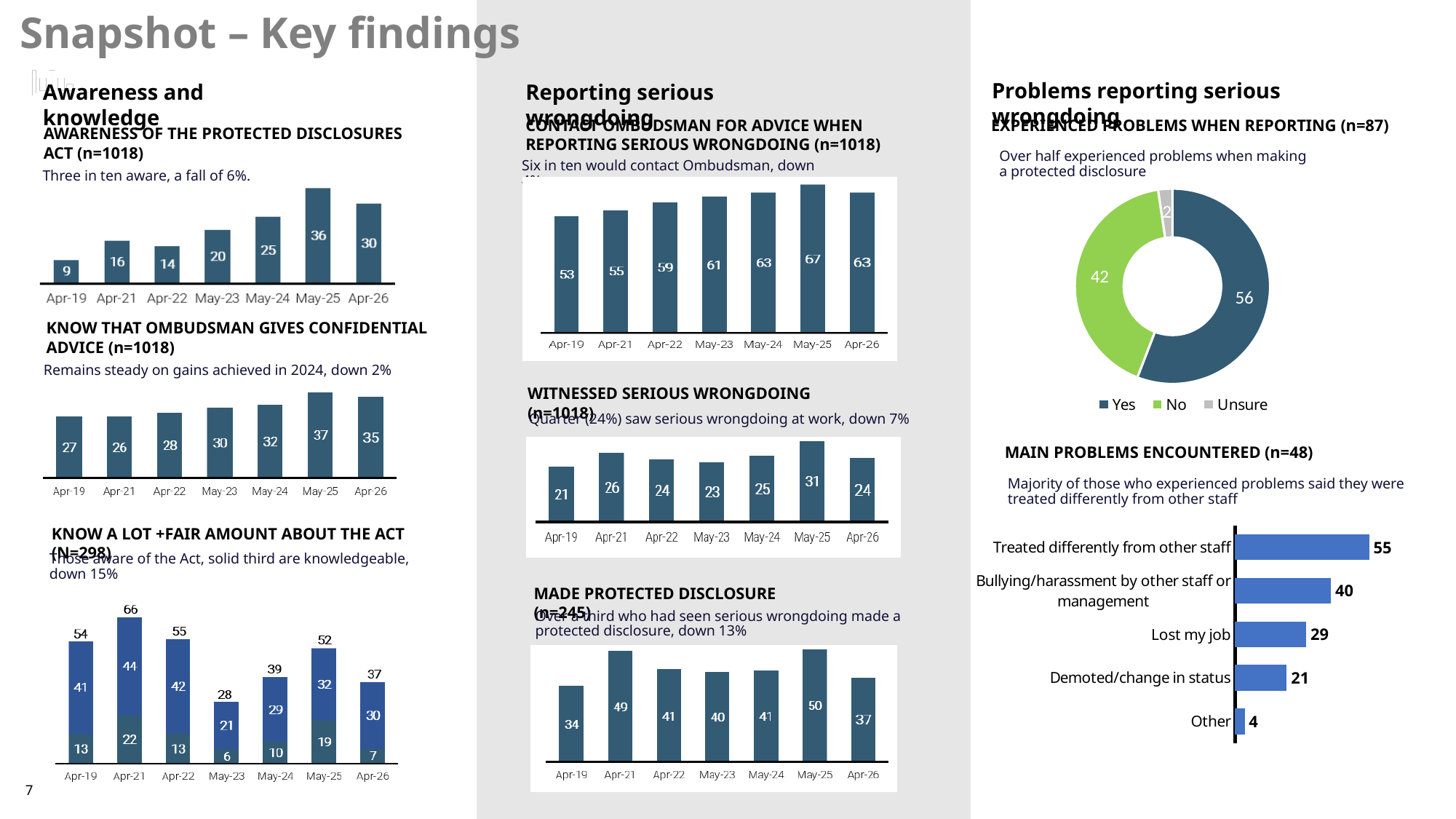
In the 'KNOW A LOT + FAIR AMOUNT ABOUT THE ACT' chart, what is the total for the Apr-21 bar? 66 In the 'WITNESSED SERIOUS WRONGDOING' chart, what is the value for Apr-21? 26 In the 'KNOW A LOT + FAIR AMOUNT ABOUT THE ACT' chart, what is the value of the lower (darker) segment for May-25? 19 In the 'MADE PROTECTED DISCLOSURE' chart, which is larger, the value for Apr-19 or the value for Apr-26? Apr-26 In the 'MAIN PROBLEMS ENCOUNTERED' chart, what is the value for 'Lost my job'? 29 In the 'EXPERIENCED PROBLEMS WHEN REPORTING' donut chart, what is the value for 'No'? 42 How many series does the legend of the 'EXPERIENCED PROBLEMS WHEN REPORTING' chart list? 3 In the 'CONTACT OMBUDSMAN FOR ADVICE WHEN REPORTING SERIOUS WRONGDOING' chart, which period has the highest value? May-25 In the 'CONTACT OMBUDSMAN FOR ADVICE WHEN REPORTING SERIOUS WRONGDOING' chart, how many periods are shown on the x axis? 7 In the 'AWARENESS OF THE PROTECTED DISCLOSURES ACT' chart, which period has the lowest value? Apr-19 In the 'KNOW THAT OMBUDSMAN GIVES CONFIDENTIAL ADVICE' chart, what is the difference between the May-25 and Apr-26 values? 2 In the 'AWARENESS OF THE PROTECTED DISCLOSURES ACT' chart, what is the value for May-25? 36